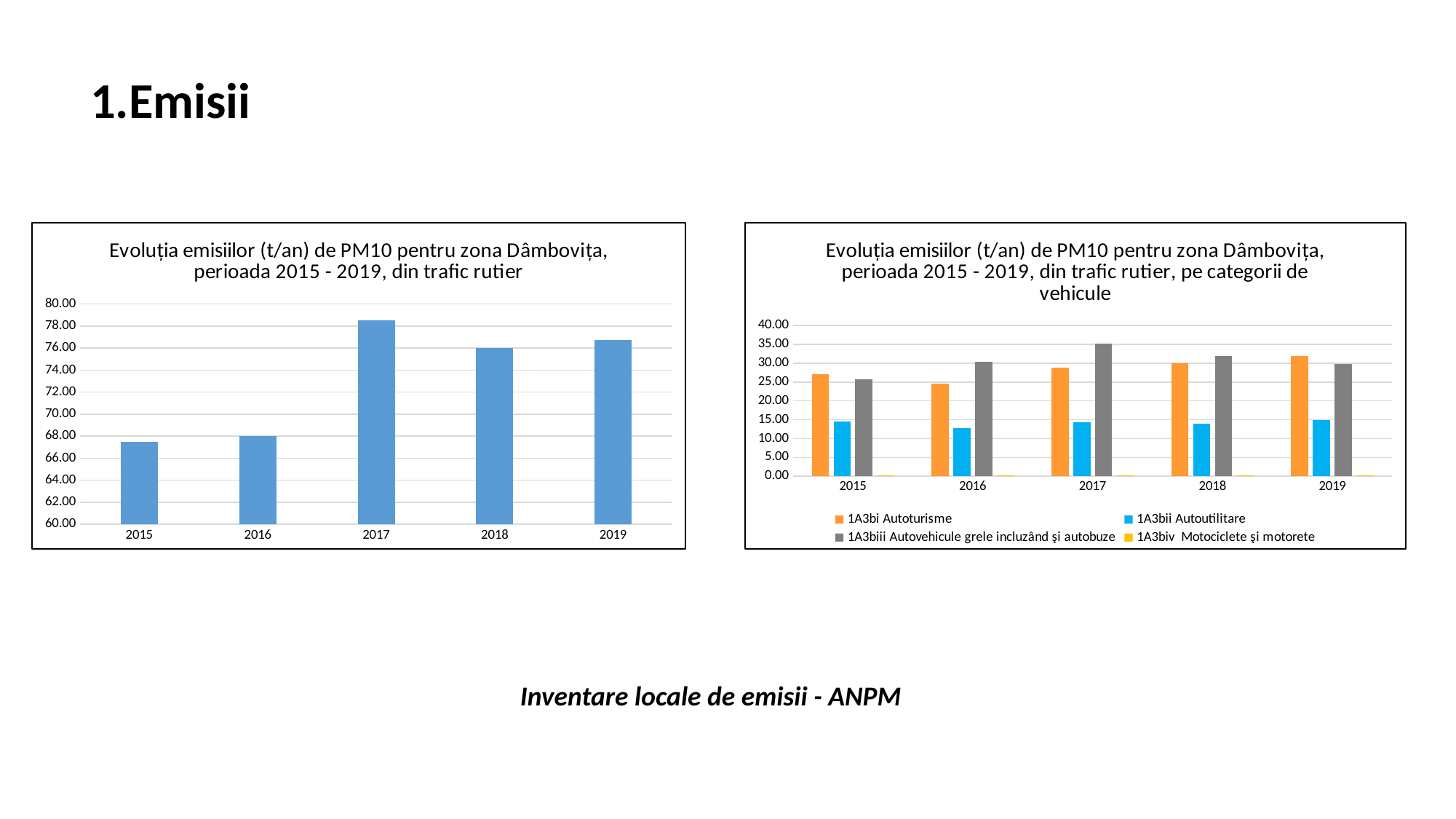
How many series does the legend of the right chart (emissions by vehicle category) list? 4 In the left chart (emissions from road traffic), which year has the highest PM10 emissions? 2017 In the left chart (emissions from road traffic), how many years are shown on the x axis? 5 In the left chart (emissions from road traffic), is the value for 2015 greater or less than 70.00? less In the right chart (emissions by vehicle category), what colour represents 1A3bi Autoturisme? Orange In the right chart (emissions by vehicle category), which year has the highest value for 1A3biii Autovehicule grele incluzând și autobuze? 2017 What kind of chart is the left chart, 'Evoluția emisiilor (t/an) de PM10 pentru zona Dâmbovița, perioada 2015 - 2019, din trafic rutier'? Bar chart In the left chart (emissions from road traffic), is the value for 2017 greater or less than 76.00? greater In the right chart (emissions by vehicle category), in 2017 which is larger, 1A3bi Autoturisme or 1A3biii Autovehicule grele incluzând și autobuze? 1A3biii Autovehicule grele incluzând și autobuze In the right chart (emissions by vehicle category), is the value for 1A3bii Autoutilitare in 2015 greater or less than 20.00? less In the right chart (emissions by vehicle category), which year has the lowest value for 1A3bii Autoutilitare? 2016 In the left chart (emissions from road traffic), which is larger, the value for 2018 or the value for 2016? 2018